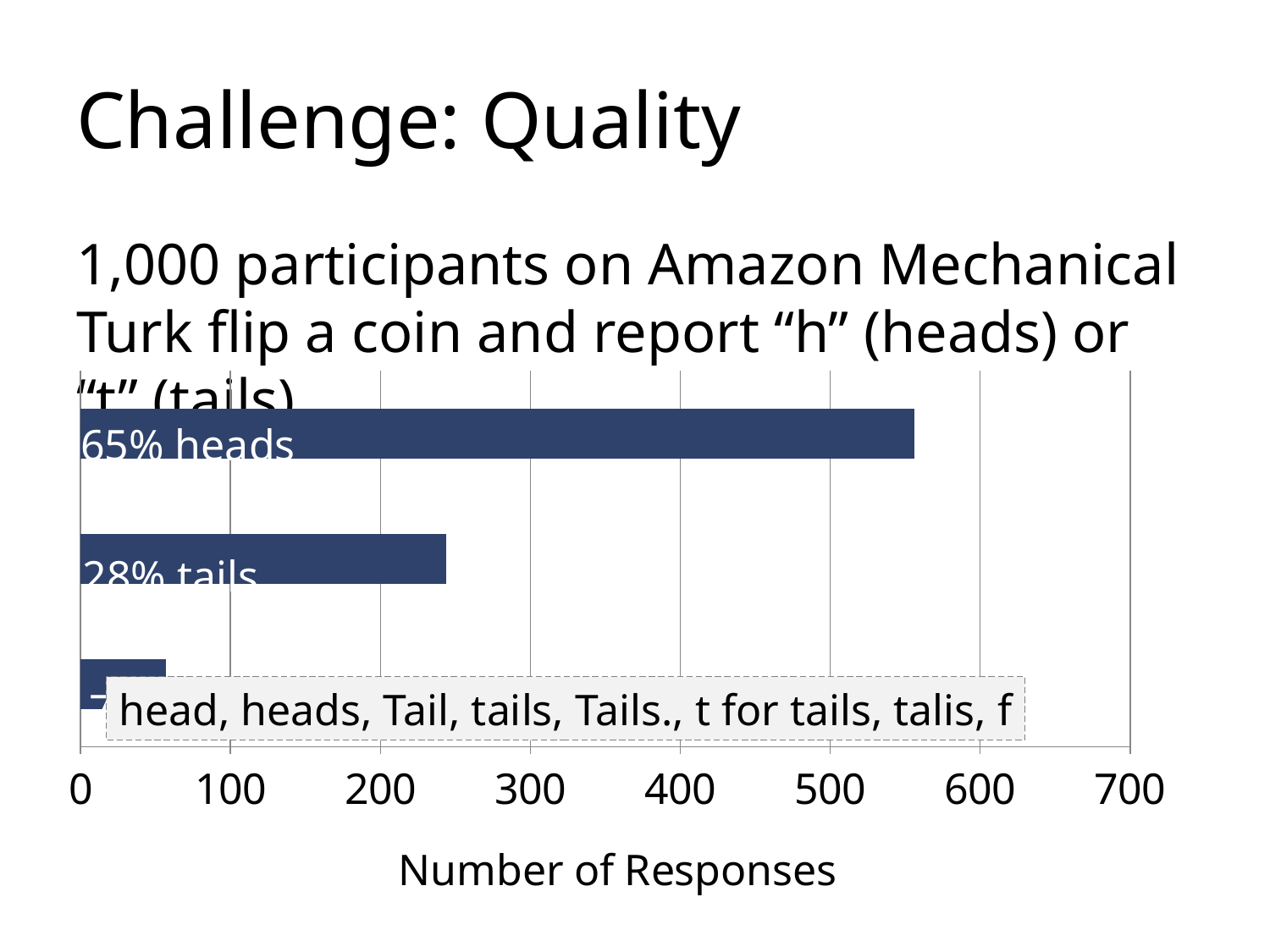
Which bar is longer, "65% heads" or "28% tails"? 65% heads Is the number of responses for "28% tails" greater or less than 200? greater What is the highest value shown on the horizontal axis of the chart? 700 Is the number of responses for "65% heads" greater or less than 600? less Which bar in the chart is the longest? 65% heads What is the title of the horizontal axis of the chart? Number of Responses Is the number of responses for "65% heads" greater or less than 500? greater How many bars does the chart show? 3 What kind of chart is shown on the slide? bar chart